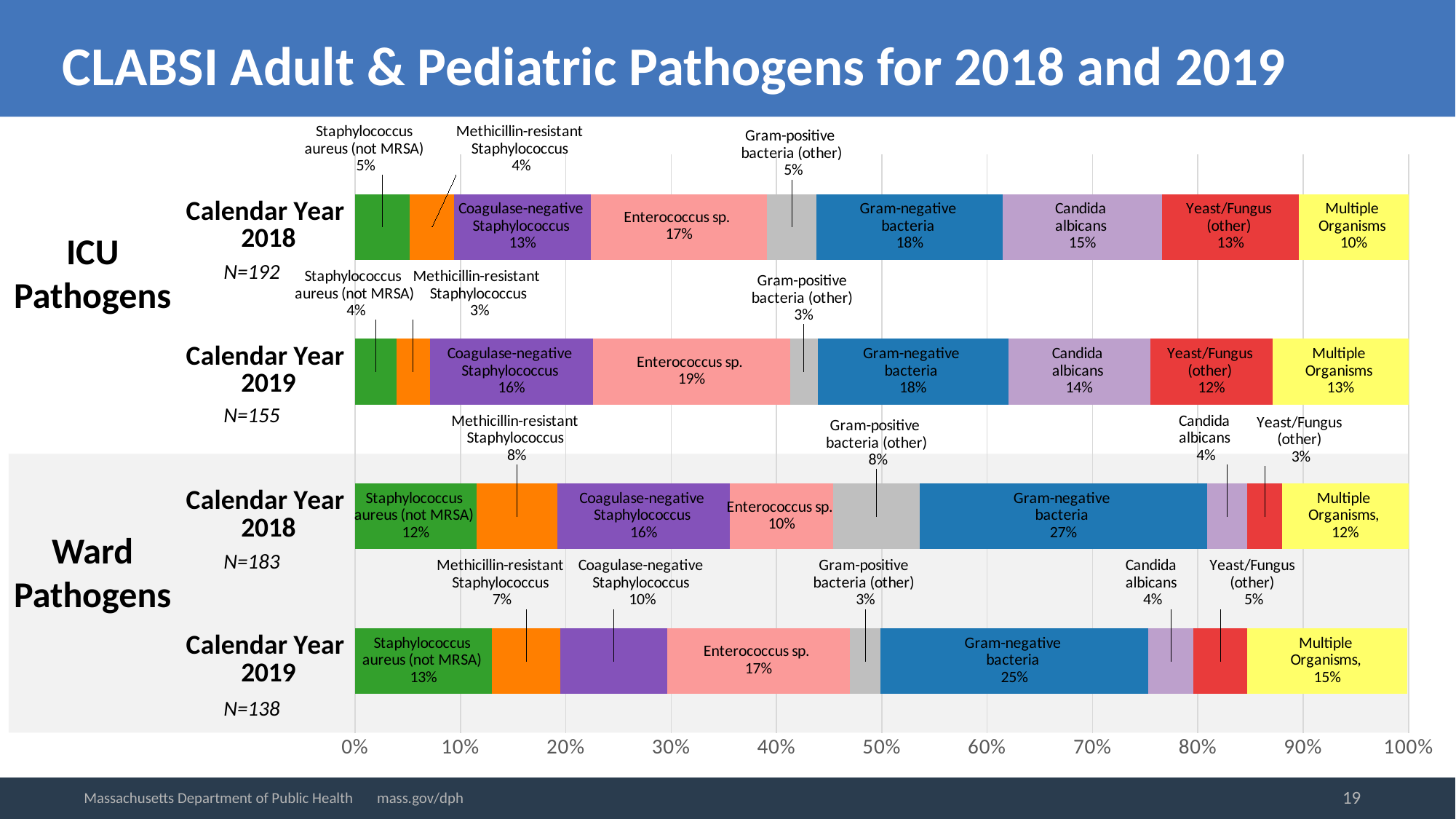
Which pathogen category has the smallest share of ICU pathogens in Calendar Year 2019? Methicillin-resistant Staphylococcus and Gram-positive bacteria (other) (both 3%) What percentage of ICU pathogens in Calendar Year 2018 were Gram-negative bacteria? 18% What percentage of Ward pathogens in Calendar Year 2019 were Enterococcus sp.? 17% What is the difference between the Gram-negative bacteria share for Ward pathogens in 2018 and in 2019? 2% What percentage of ICU pathogens in Calendar Year 2019 were Coagulase-negative Staphylococcus? 16% What is the N value for Ward pathogens in Calendar Year 2019? N=138 Which pathogen category has the largest share of Ward pathogens in Calendar Year 2018? Gram-negative bacteria Which is larger: the Multiple Organisms share for ICU pathogens in 2018 or in 2019? 2019 What kind of chart is shown on the slide? Stacked bar chart What is the title of the chart? CLABSI Adult & Pediatric Pathogens for 2018 and 2019 How many bars (calendar year groups) are plotted in the chart? 4 What is the difference between the Enterococcus sp. share for ICU pathogens in 2019 and in 2018? 2%